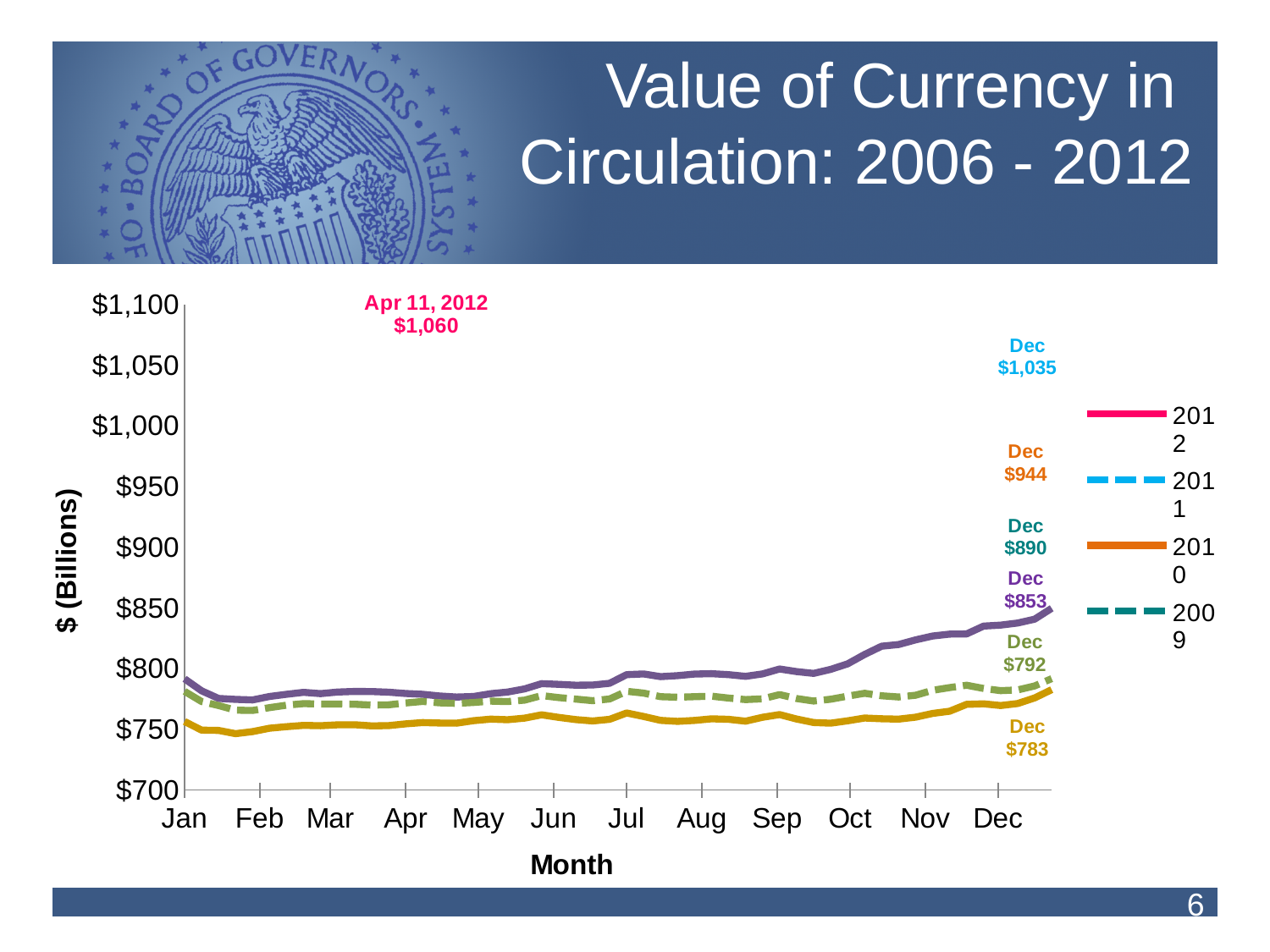
What kind of chart is shown on the slide? line chart Which is larger, the December value annotated in purple ($853) or the December value annotated in green ($792)? $853 What is the difference between the December annotations of $944 and $890? $54 How many months are labelled along the x axis of the chart? 12 What value is annotated for Apr 11, 2012 on the chart? $1,060 What is the title of the chart on the slide? Value of Currency in Circulation: 2006 - 2012 What is the highest December value annotated on the chart? $1,035 Is the value of the gold (lowest) line in Jan greater or less than $800? less What is the difference between the Apr 11, 2012 value of $1,060 and the December value of $1,035? $25 What is the lowest December value annotated on the chart? $783 What is the label on the vertical axis of the chart? $ (Billions) Does the purple (top plotted) line rise or fall from Sep to Dec? rise